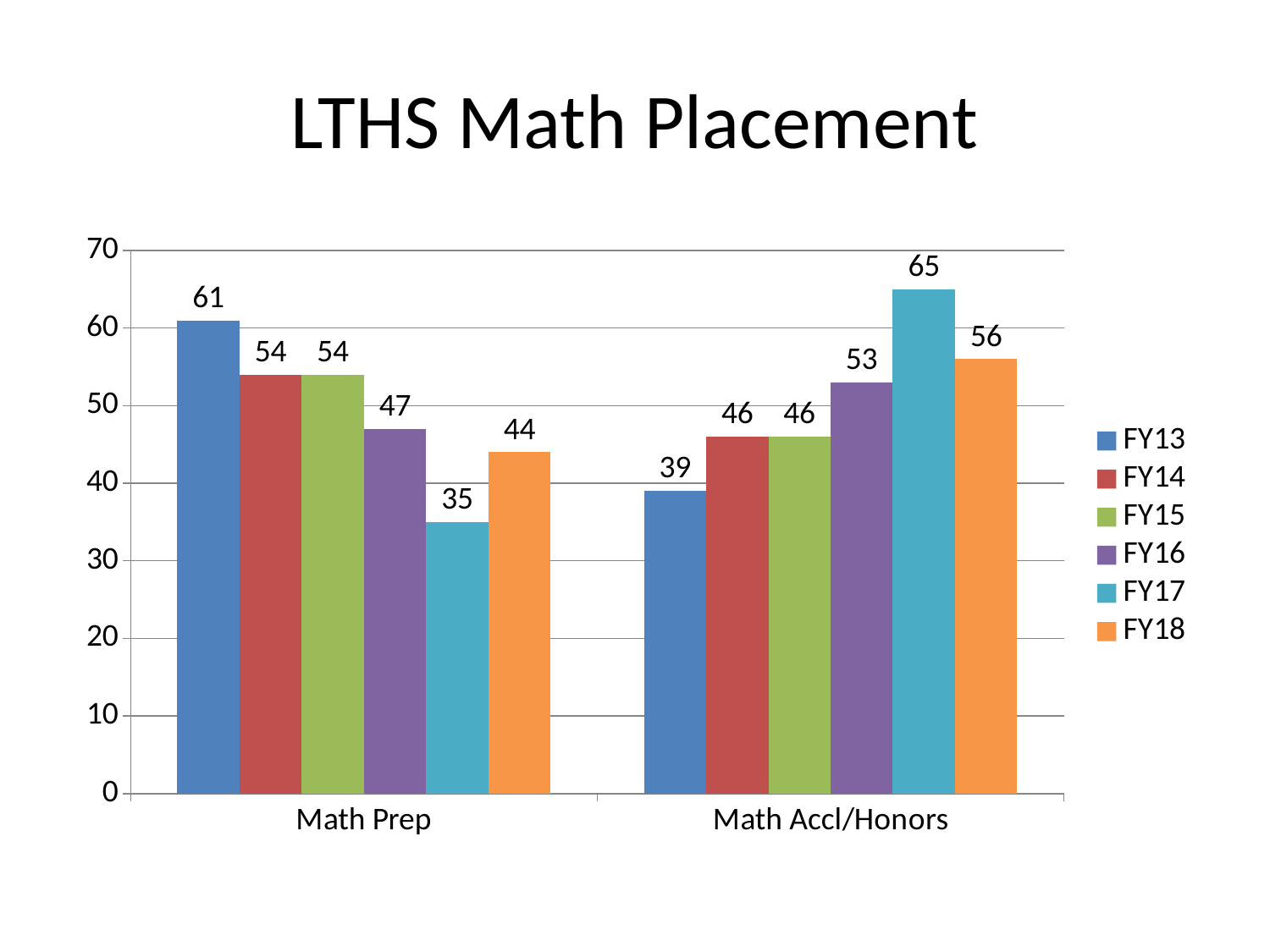
What is the value for FY18 in the Math Prep category? 44 Which series has the highest value in the Math Accl/Honors category? FY17 How many categories are shown on the x axis? 2 What is the value for FY17 in the Math Accl/Honors category? 65 What kind of chart is shown on the slide? bar chart Which is larger: the FY16 value for Math Prep or the FY16 value for Math Accl/Honors? Math Accl/Honors What is the difference between the FY13 value for Math Prep and the FY13 value for Math Accl/Honors? 22 Which series has the lowest value in the Math Prep category? FY17 What is the title of the chart? LTHS Math Placement How many series does the legend list? 6 Is the FY14 value for Math Accl/Honors greater or less than 50? less What is the value for FY13 in the Math Prep category? 61